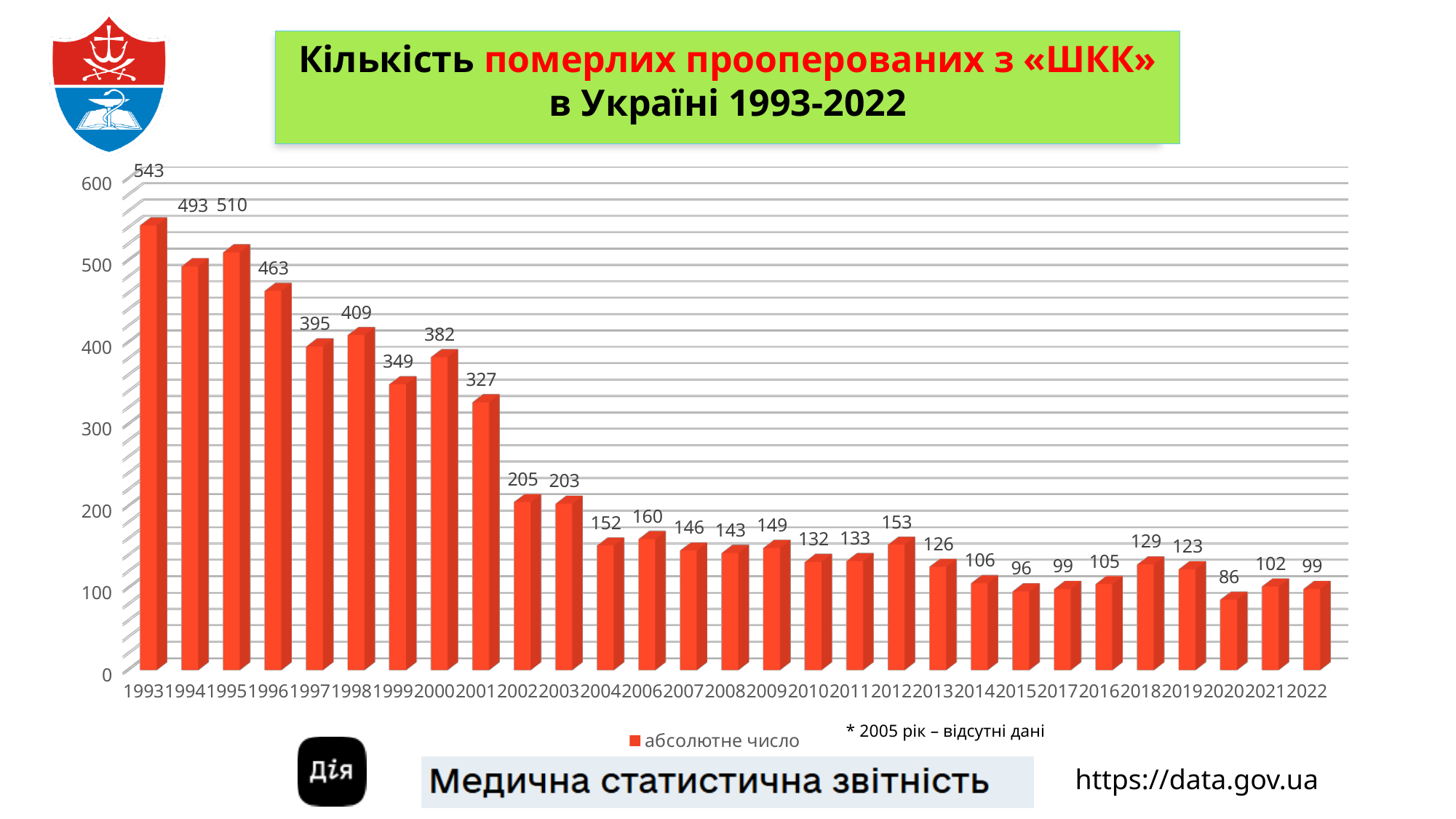
How many years (bars) are plotted on the chart? 29 What is the difference between the values for 1993 and 2022? 444 Which year has the lowest value? 2020 What is the value for 2020? 86 What is the value for 1993? 543 Do the values generally rise or fall from 1993 to 2022? fall Which year has the highest value? 1993 What is the value for 2012? 153 What type of chart is shown on the slide? bar chart How many series does the legend list? 1 Which is larger, the value for 1995 or the value for 1994? 1995 What is the legend entry for the series? абсолютне число